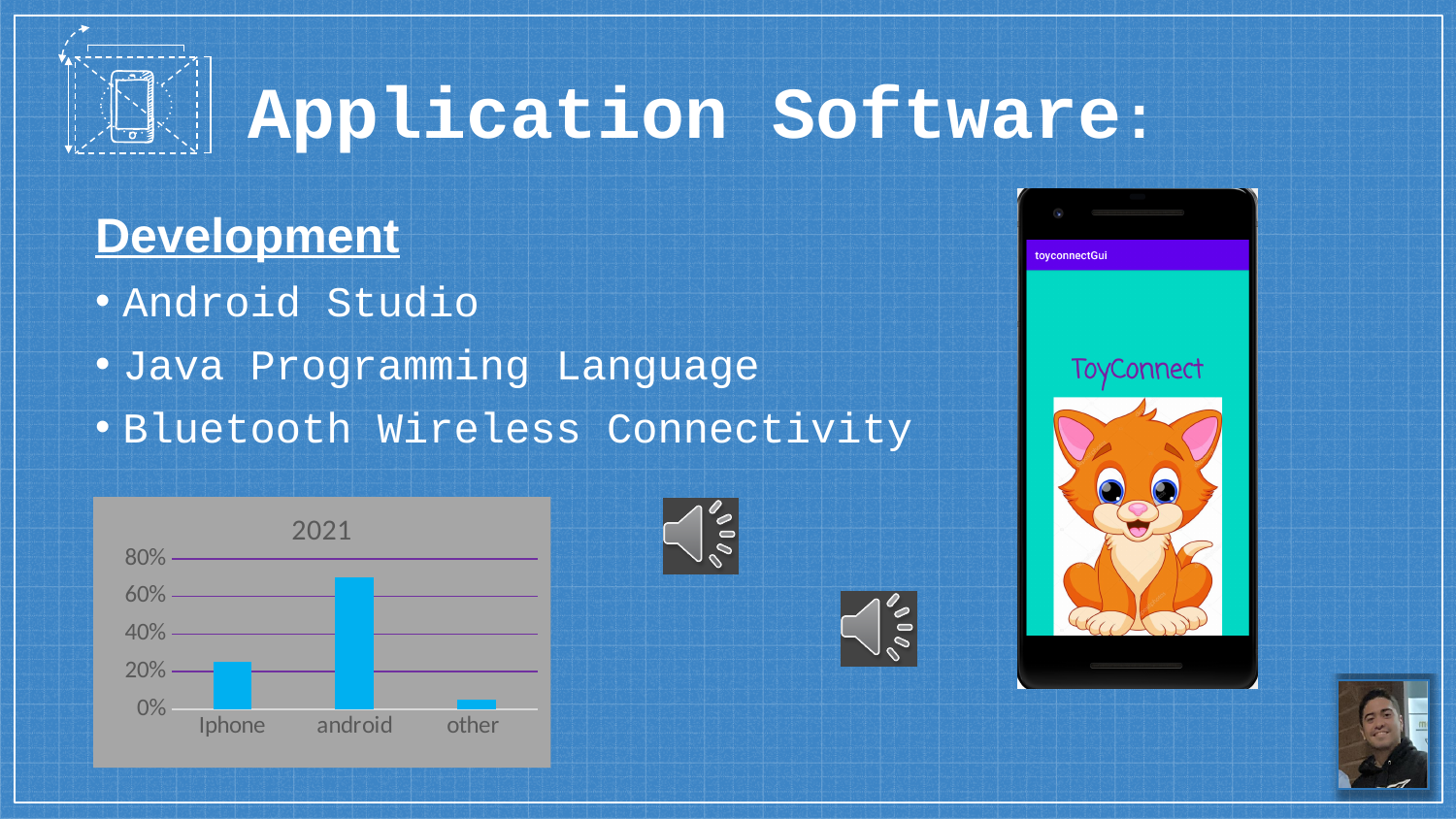
Is the value for android greater or less than 80%? less What is the highest value labelled on the vertical axis of the chart? 80% Which category has the lowest value in the chart? other What kind of chart is shown on the slide? bar chart Is the value for android greater or less than 60%? greater Which is larger, the value for Iphone or the value for android? android Is the value for other greater or less than 20%? less Which is larger, the value for Iphone or the value for other? Iphone How many categories are shown on the x axis of the chart? 3 What is the title of the chart? 2021 Which category has the highest value in the chart? android